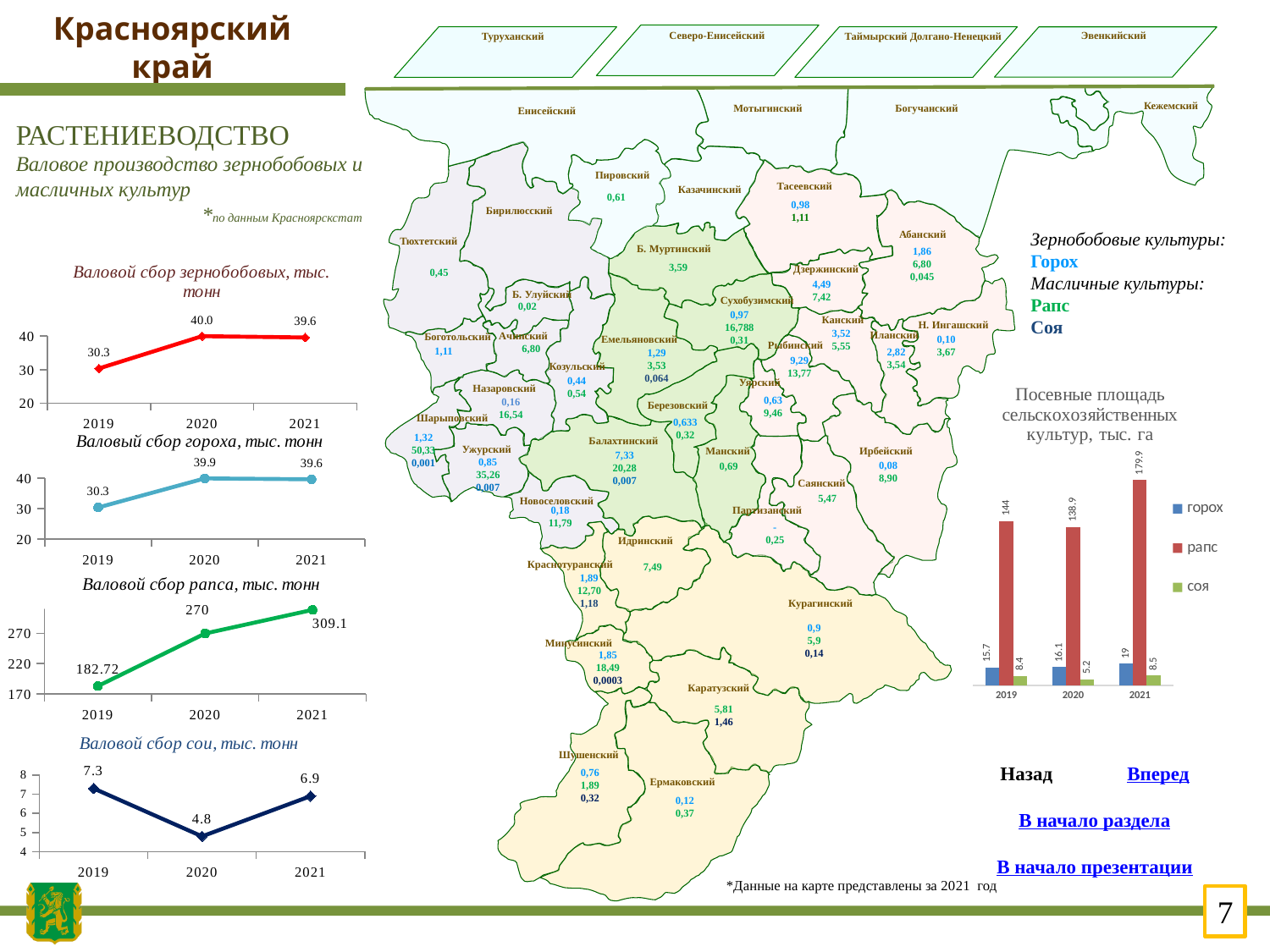
On the chart 'Валовой сбор рапса, тыс. тонн', what is the value for 2019? 182.72 On the chart 'Валовой сбор зернобобовых, тыс. тонн', what is the value for 2020? 40.0 On the chart 'Валовой сбор рапса, тыс. тонн', do the values rise or fall from 2019 to 2021? rise On the chart 'Валовой сбор гороха, тыс. тонн', what is the value for 2021? 39.6 On the chart 'Валовой сбор сои, тыс. тонн', which is larger: the value for 2019 or the value for 2021? 2019 On the chart 'Валовой сбор гороха, тыс. тонн', what is the difference between the 2020 and 2019 values? 9.6 On the chart 'Валовой сбор зернобобовых, тыс. тонн', which year has the lowest value? 2019 On the chart 'Валовой сбор сои, тыс. тонн', which year has the highest value? 2019 On the bar chart 'Посевные площади сельскохозяйственных культур, тыс. га', what is the value for рапс in 2021? 179.9 On the bar chart 'Посевные площади сельскохозяйственных культур, тыс. га', how many series does the legend list? 3 On the bar chart 'Посевные площади сельскохозяйственных культур, тыс. га', what is the value for соя in 2020? 5.2 On the chart 'Валовой сбор сои, тыс. тонн', what is the value for 2020? 4.8